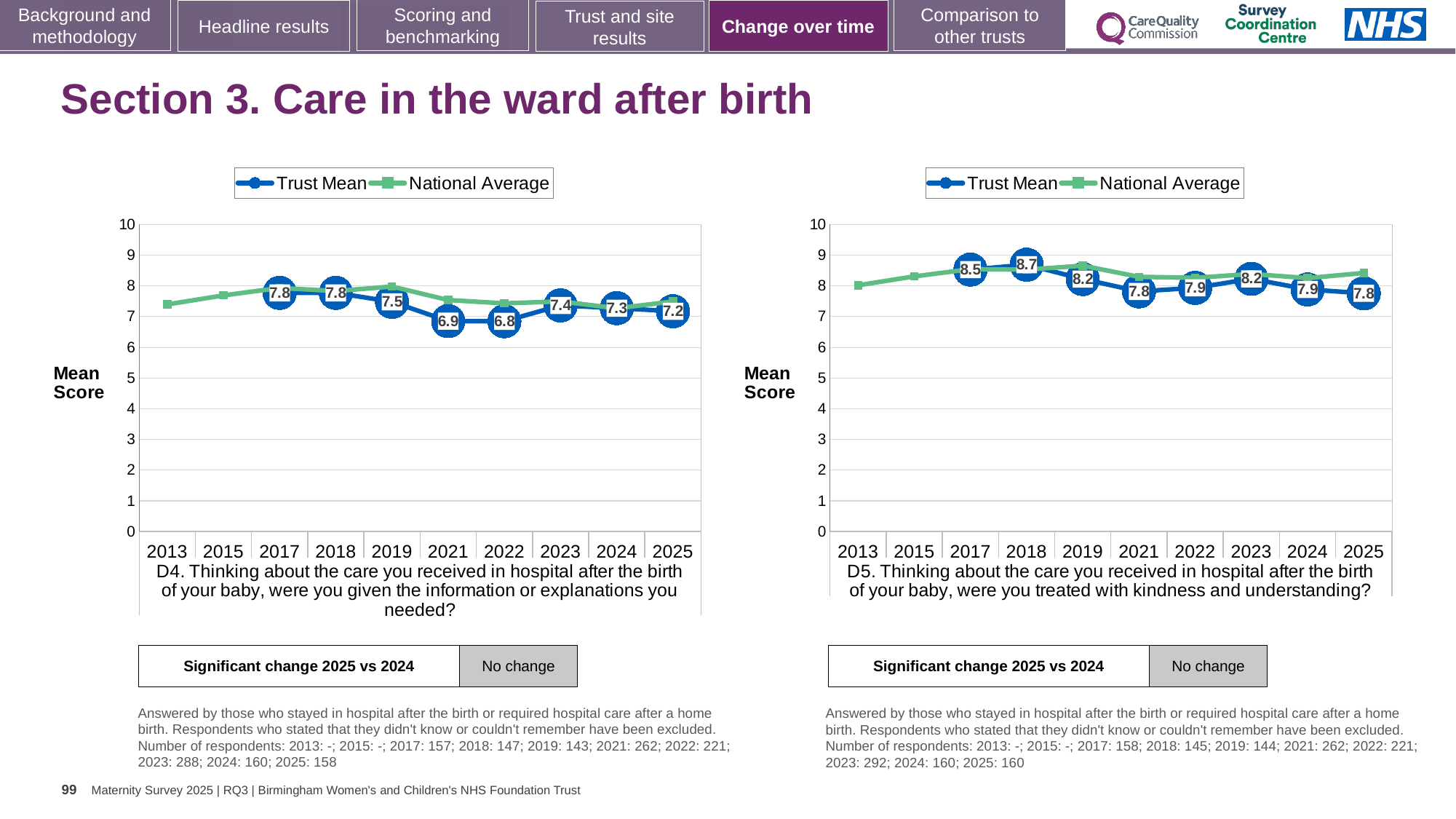
In the D4 chart, is the National Average for 2013 greater or less than 7? greater In the D4 chart, does the Trust Mean rise or fall from 2019 to 2022? Fall In the D5 chart, is the Trust Mean higher in 2017 or in 2025? 2017 How many series does the legend of the D4 chart list? 2 In the D4 chart, what is the Trust Mean for 2025? 7.2 In the D4 chart, what is the difference between the Trust Mean in 2018 and in 2022? 1.0 How many years are shown on the x axis of the D5 chart? 10 What does the box below the D5 chart say about the significant change 2025 vs 2024? No change In the D4 chart, which year has the lowest Trust Mean? 2022 In the D5 chart, which year has the highest Trust Mean? 2018 In the D5 chart, what is the Trust Mean for 2018? 8.7 What kind of chart is the D5 chart? Line chart